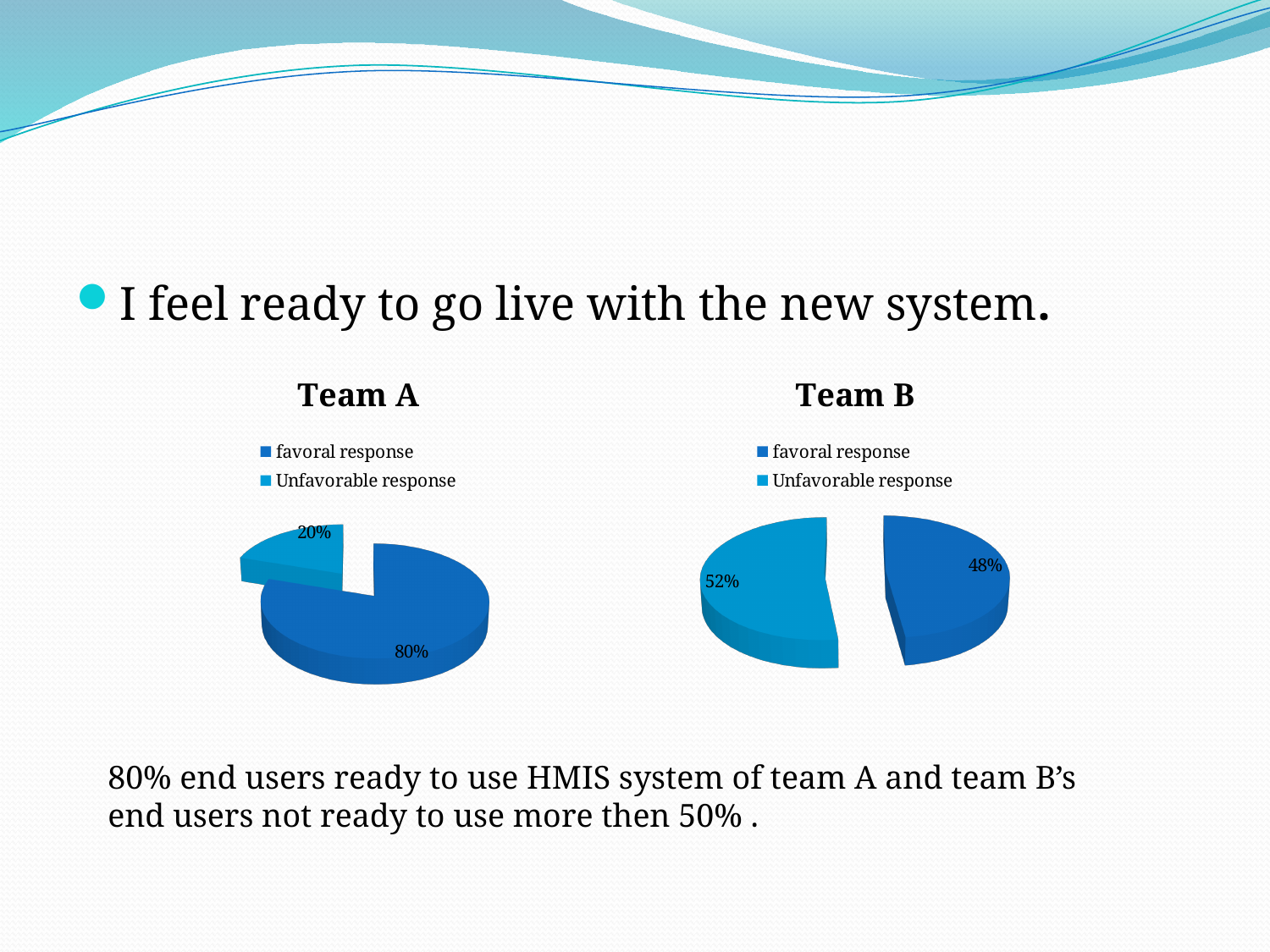
Which chart has the larger favoral response slice, Team A or Team B? Team A How many entries does the legend of the Team A chart list? 2 What type of chart is the Team A chart? Pie chart In the Team A chart, what percentage is the Unfavorable response slice? 20% In the Team A chart, what is the difference between the favoral response and Unfavorable response slices? 60% In the Team A chart, what percentage is the favoral response slice? 80% In the Team B chart, which slice is the smallest? favoral response How many slices does the Team B chart have? 2 In the Team B chart, what percentage is the Unfavorable response slice? 52% In the Team B chart, what percentage is the favoral response slice? 48% In the Team A chart, which slice is the largest? favoral response In the Team B chart, what is the difference between the Unfavorable response and favoral response slices? 4%